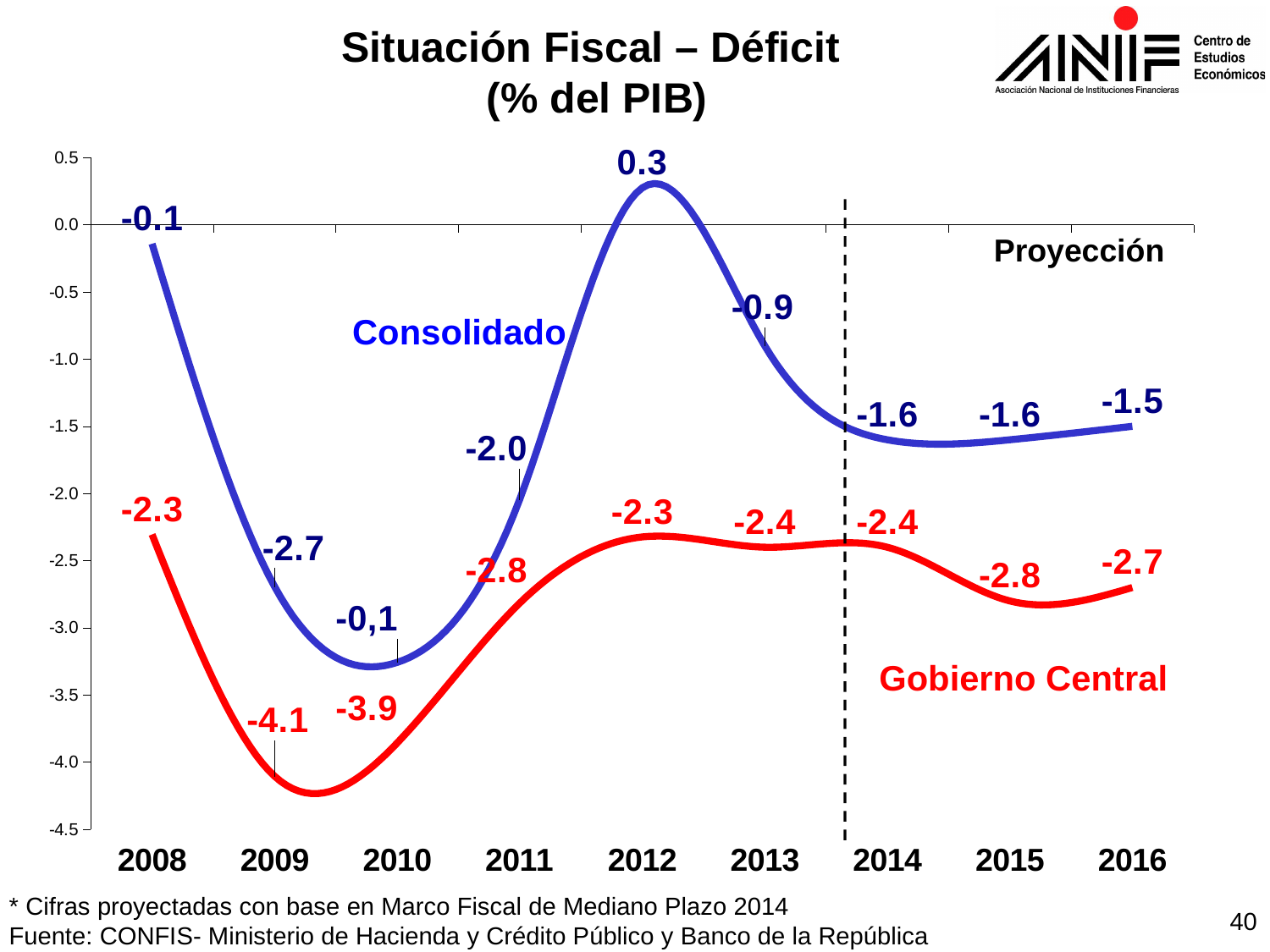
How many series are plotted on the chart? 2 In 2013, which series has the higher value, Consolidado or Gobierno Central? Consolidado How many years are shown on the x axis? 9 What is the Gobierno Central value for 2009? -4.1 What is the difference between the Consolidado and Gobierno Central values in 2012? 2.6 In which year does the Consolidado series reach its highest value? 2012 What is the Consolidado value for 2012? 0.3 What is the Consolidado value for 2016? -1.5 What kind of chart is shown on the slide? Line chart Does the Gobierno Central series rise or fall from 2008 to 2009? Fall In which year does the Gobierno Central series reach its lowest value? 2009 What is the difference between the Gobierno Central values for 2009 and 2010? 0.2